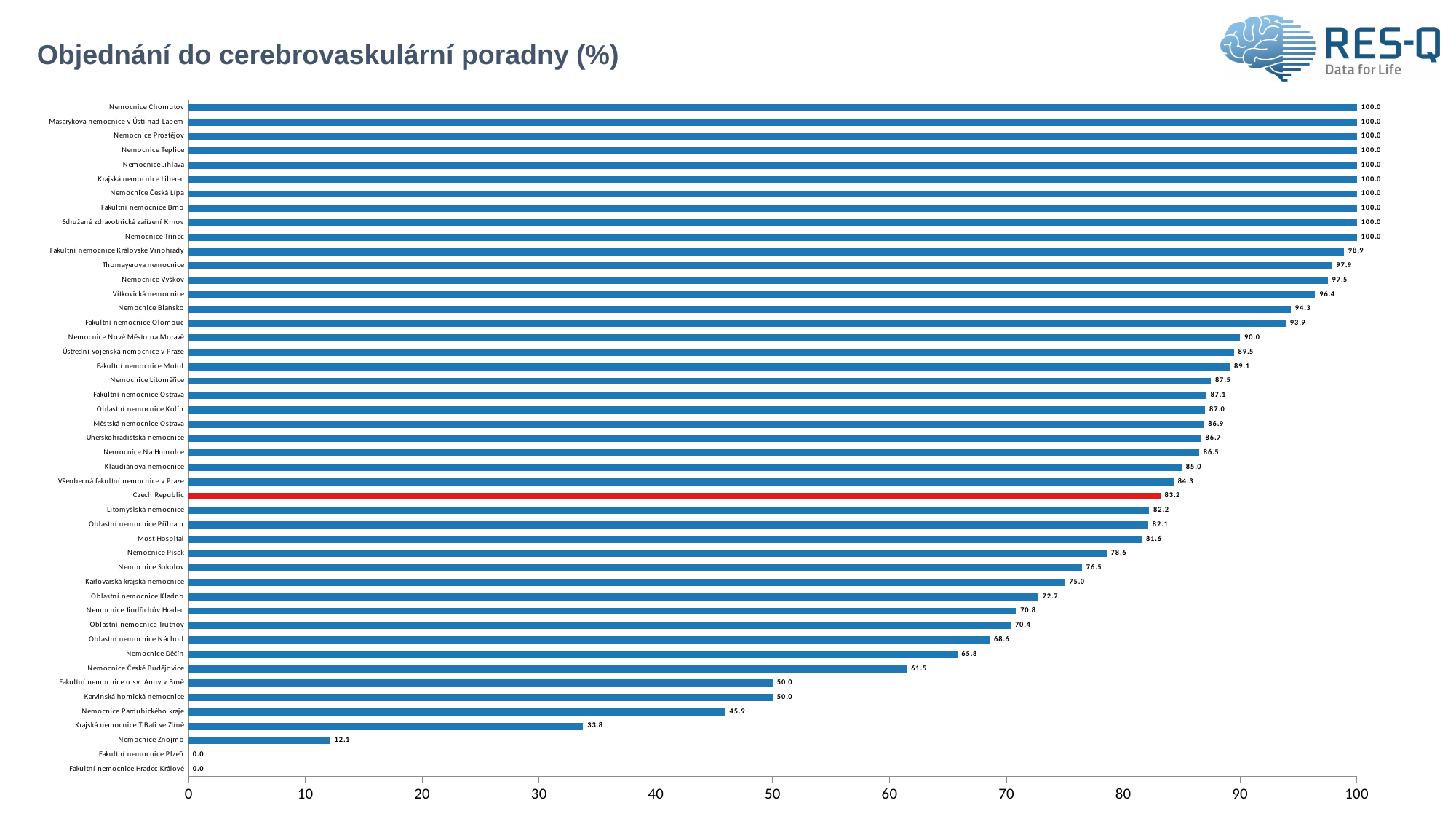
What is the title of the chart? Objednání do cerebrovaskulární poradny (%) What is the value for Czech Republic? 83.2 What is the value for Fakultní nemocnice Motol? 89.1 Which bar is highlighted in red? Czech Republic How many hospitals have a value of 100.0? 10 How many categories are plotted on the chart? 47 Is the value for Nemocnice České Budějovice greater or less than 60? greater What is the difference between the values for Nemocnice Písek and Nemocnice Sokolov? 2.1 Which has a larger value, Oblastní nemocnice Kladno or Nemocnice Děčín? Oblastní nemocnice Kladno What is the value for Krajská nemocnice T.Bati ve Zlíně? 33.8 What kind of chart is shown on the slide? Bar chart What is the value for Nemocnice Znojmo? 12.1